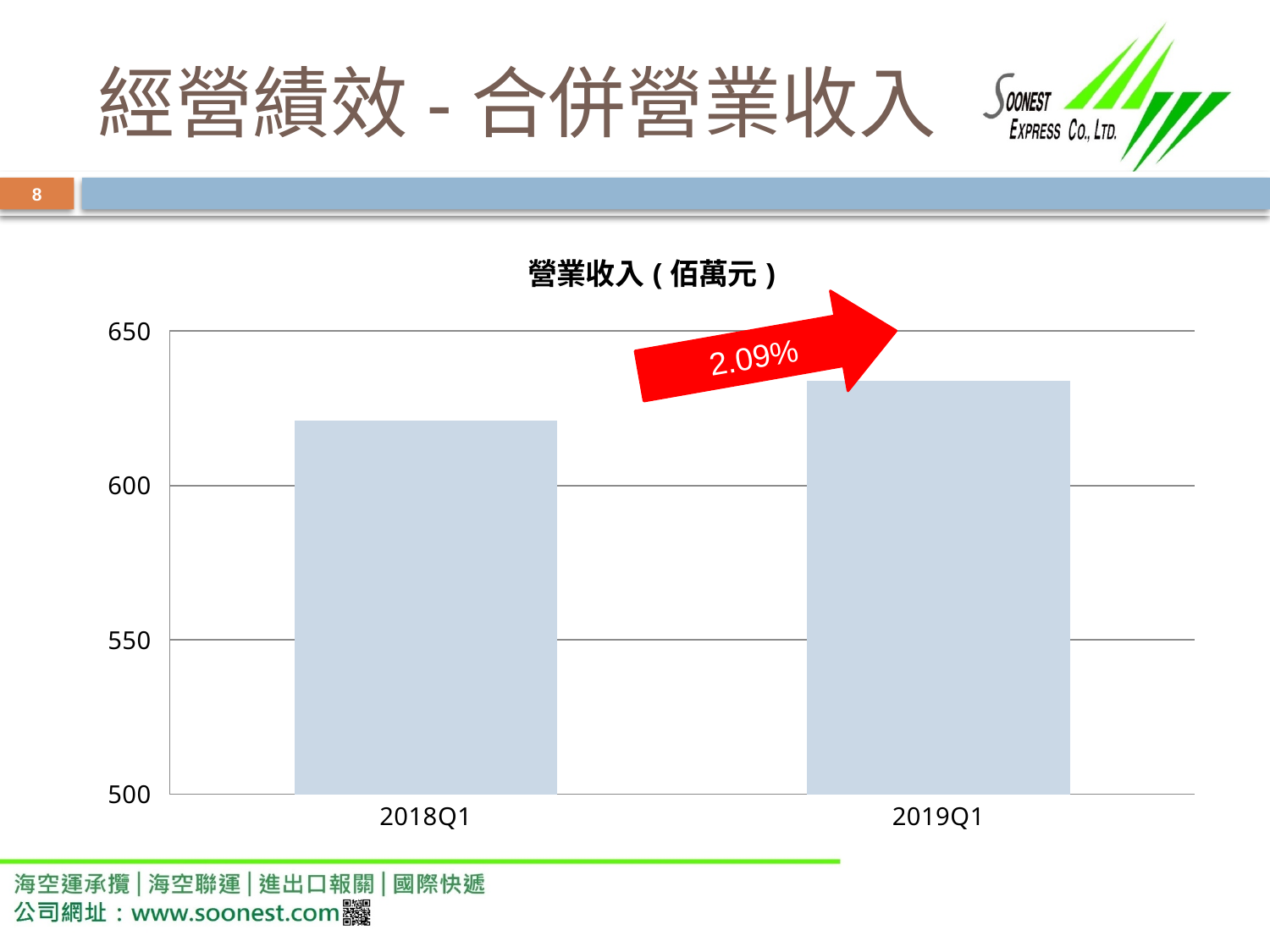
Which is larger, the value for 2018Q1 or the value for 2019Q1? 2019Q1 Is the value for 2019Q1 greater or less than 650? less How many categories are plotted on the x axis of the chart? 2 What is the title of the chart? 營業收入（佰萬元） Is the value for 2019Q1 greater or less than 600? greater Is the value for 2018Q1 greater or less than 650? less What percentage change is shown on the red arrow between the two bars? 2.09% Do the values rise or fall from 2018Q1 to 2019Q1? rise Which category has the lowest value in the chart? 2018Q1 Which category has the highest value in the chart? 2019Q1 What kind of chart is shown on the slide? bar chart